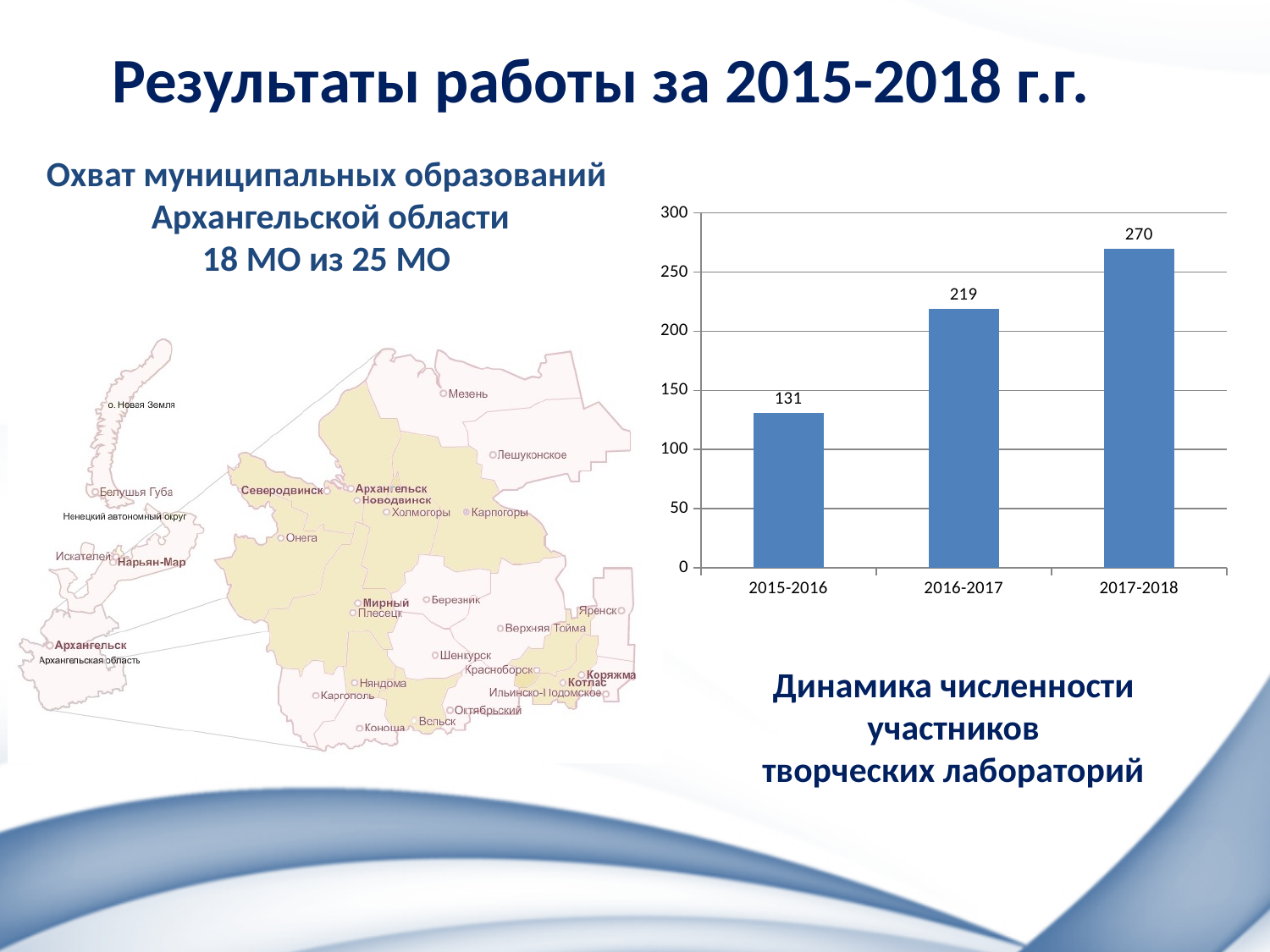
Which period has the lowest value in the bar chart? 2015-2016 What is the difference between the values for 2016-2017 and 2015-2016? 88 What is the difference between the values for 2017-2018 and 2015-2016? 139 Is the value for 2016-2017 greater or less than 200? greater Which period has the highest value in the bar chart? 2017-2018 What is the value for 2015-2016 in the bar chart? 131 How many periods are shown on the x axis of the bar chart? 3 Which is larger, the value for 2016-2017 or the value for 2017-2018? 2017-2018 Do the values in the bar chart rise or fall from 2015-2016 to 2017-2018? rise What is the value for 2016-2017 in the bar chart? 219 What kind of chart is shown on the right of the slide? bar chart What is the value for 2017-2018 in the bar chart? 270